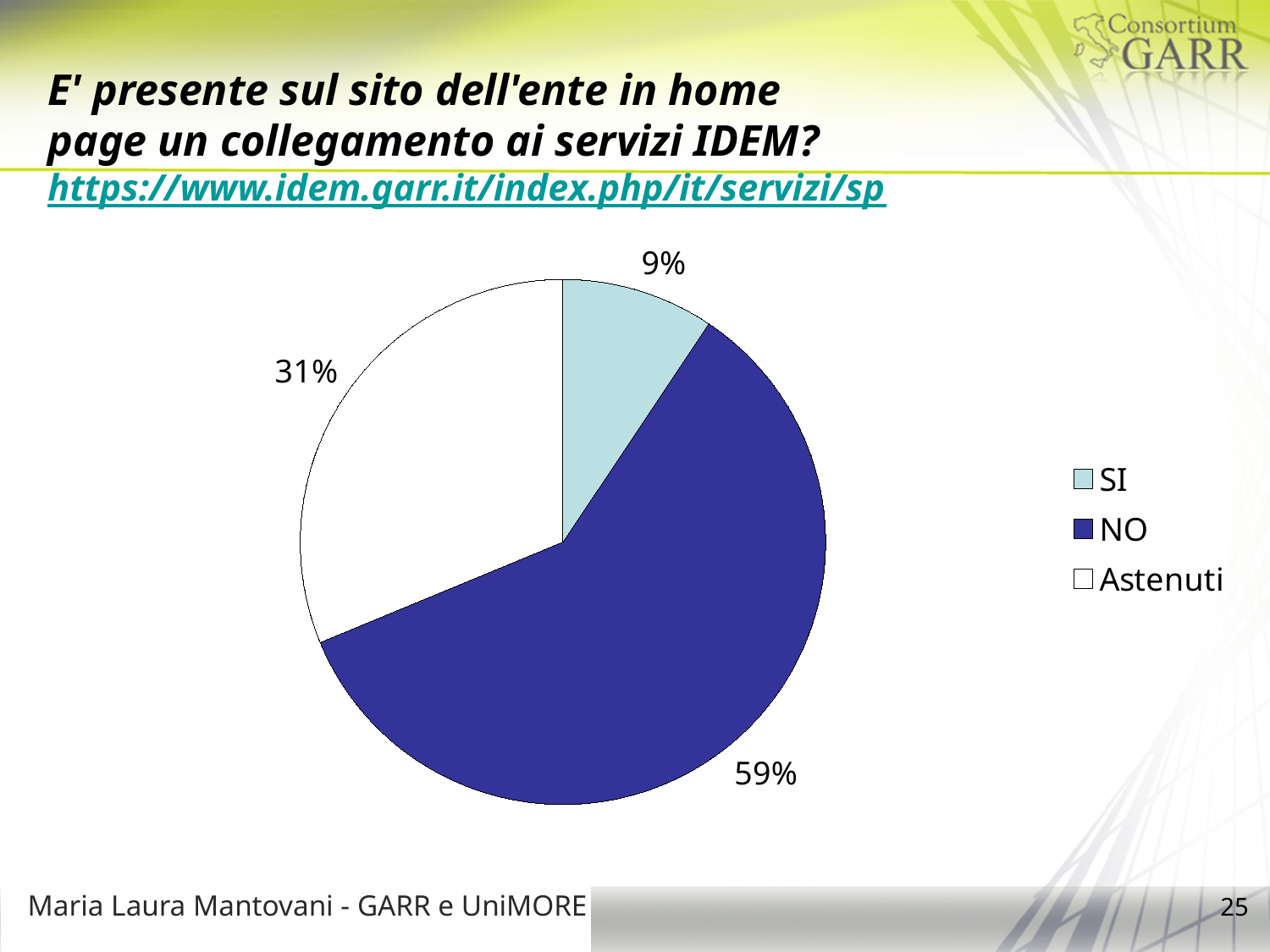
What is the difference in percentage points between the Astenuti slice and the SI slice? 22 What percentage of the pie is the Astenuti slice? 31% How many categories does the legend list? 3 What kind of chart is shown on the slide? pie chart What colour is the NO slice in the pie chart? dark blue Which category has the smallest slice of the pie? SI What percentage of the pie is the NO slice? 59% Which slice is larger, SI or Astenuti? Astenuti Which category has the largest slice of the pie? NO Which category is shown in white in the pie chart? Astenuti What is the difference in percentage points between the NO slice and the Astenuti slice? 28 What percentage of the pie is the SI slice? 9%